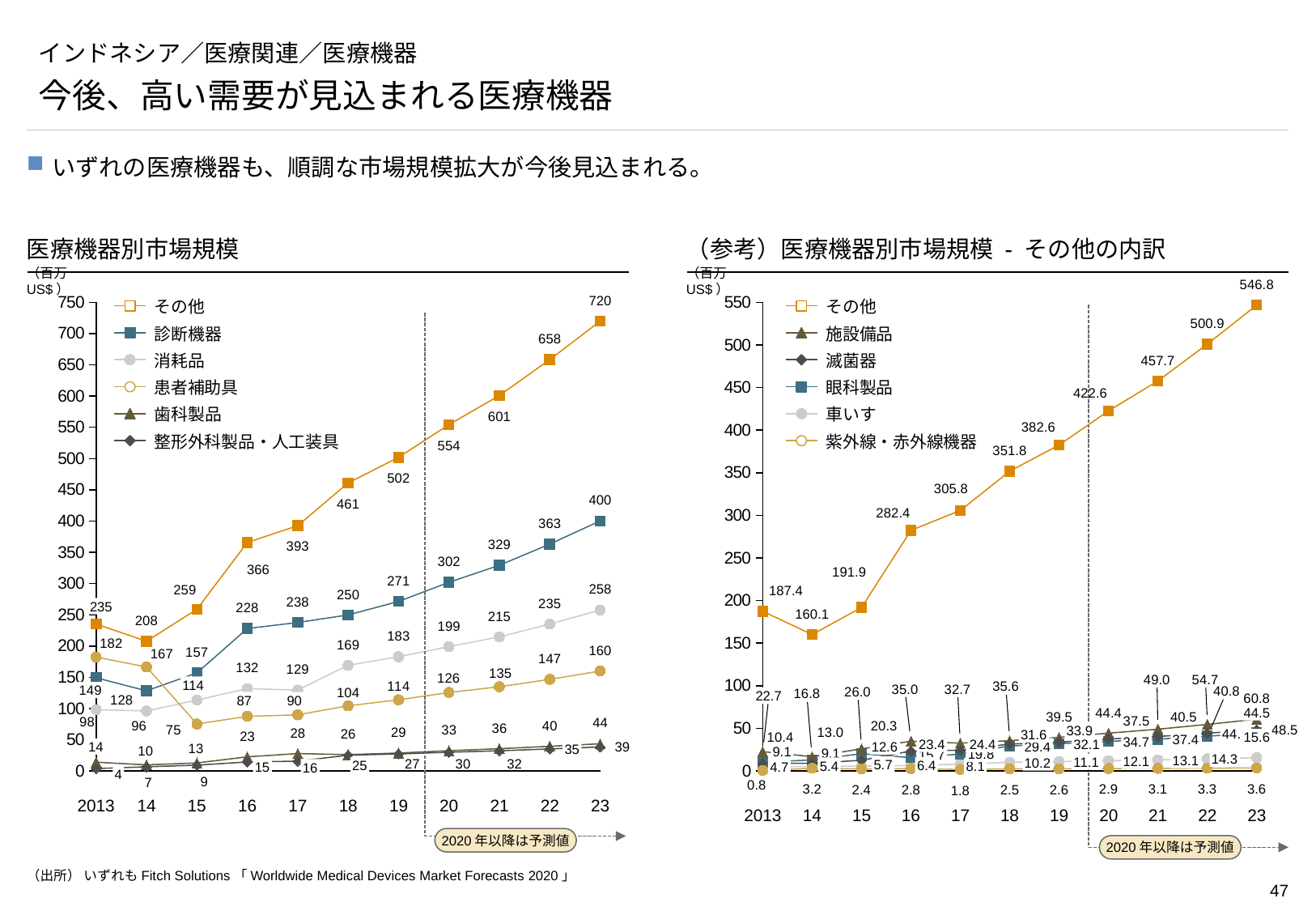
On the left chart (医療機器別市場規模), in which year is the value for その他 lowest? 2014 On the left chart (医療機器別市場規模), what is the value for 消耗品 in 2023? 258 On the right chart (医療機器別市場規模 - その他の内訳), do the values for その他 rise or fall from 2015 to 2023? Rise On the left chart (医療機器別市場規模), what is the value for 患者補助具 in 2013? 182 On the left chart (医療機器別市場規模), what is the value for 診断機器 in 2020? 302 What kind of chart is the right chart (医療機器別市場規模 - その他の内訳)? Line chart On the right chart (医療機器別市場規模 - その他の内訳), in which year is the value for その他 lowest? 2014 On the left chart (医療機器別市場規模), what is the difference between the その他 values for 2023 and 2022? 62 On the right chart (医療機器別市場規模 - その他の内訳), what is the value for その他 in 2023? 546.8 On the left chart (医療機器別市場規模), which is larger in 2023, 診断機器 or 消耗品? 診断機器 On the left chart (医療機器別市場規模), what is the value for その他 in 2023? 720 On the left chart (医療機器別市場規模), how many series does the legend list? 6